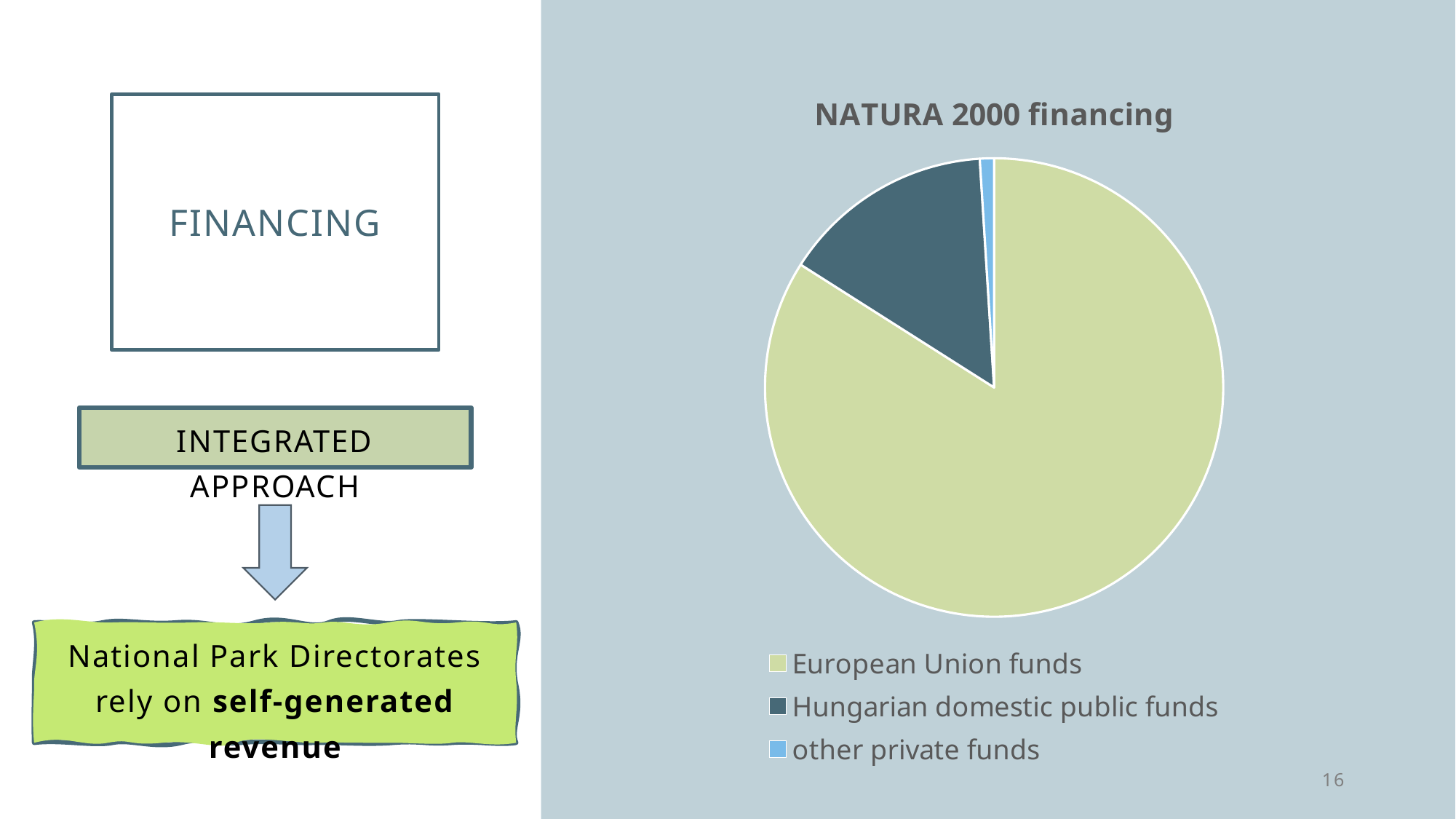
Which is larger: the slice for Hungarian domestic public funds or the slice for other private funds? Hungarian domestic public funds Which legend entry is shown in dark blue-grey? Hungarian domestic public funds Which category has the smallest slice of the pie? other private funds Does the European Union funds slice make up more or less than half of the pie? more Which is larger: the slice for European Union funds or the slice for Hungarian domestic public funds? European Union funds What kind of chart is shown on the slide? pie chart How many slices does the pie chart have? 3 Which category has the largest slice of the pie? European Union funds How many entries does the legend list? 3 What is the title of the chart? NATURA 2000 financing